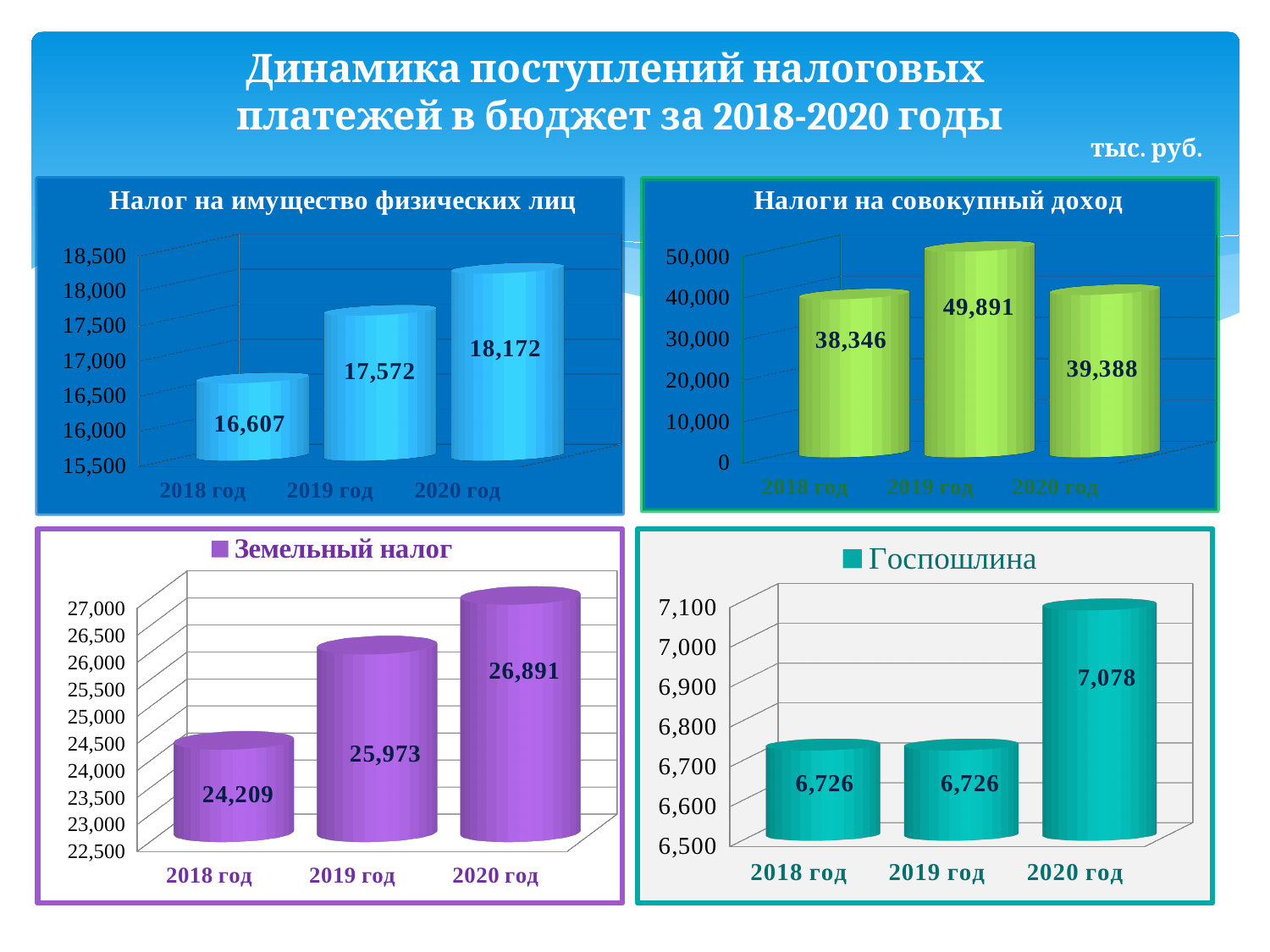
In the 'Налог на имущество физических лиц' chart, which year has the lowest value? 2018 год In the 'Земельный налог' chart, what is the difference between the 2019 год and 2018 год values? 1,764 In the 'Налог на имущество физических лиц' chart, what is the value for 2019 год? 17,572 In the 'Налоги на совокупный доход' chart, which is larger: the value for 2018 год or 2020 год? 2020 год In the 'Земельный налог' chart, do the values rise or fall from 2018 год to 2020 год? rise In the 'Земельный налог' chart, what is the value for 2018 год? 24,209 In the 'Налоги на совокупный доход' chart, what is the value for 2020 год? 39,388 In the 'Налоги на совокупный доход' chart, which year has the highest value? 2019 год In the 'Налог на имущество физических лиц' chart, what is the difference between the 2020 год and 2018 год values? 1,565 In the 'Госпошлина' chart, what is the value for 2020 год? 7,078 In the 'Госпошлина' chart, how many years are shown on the x axis? 3 How many charts are on the slide, and what type are they? 4 bar charts